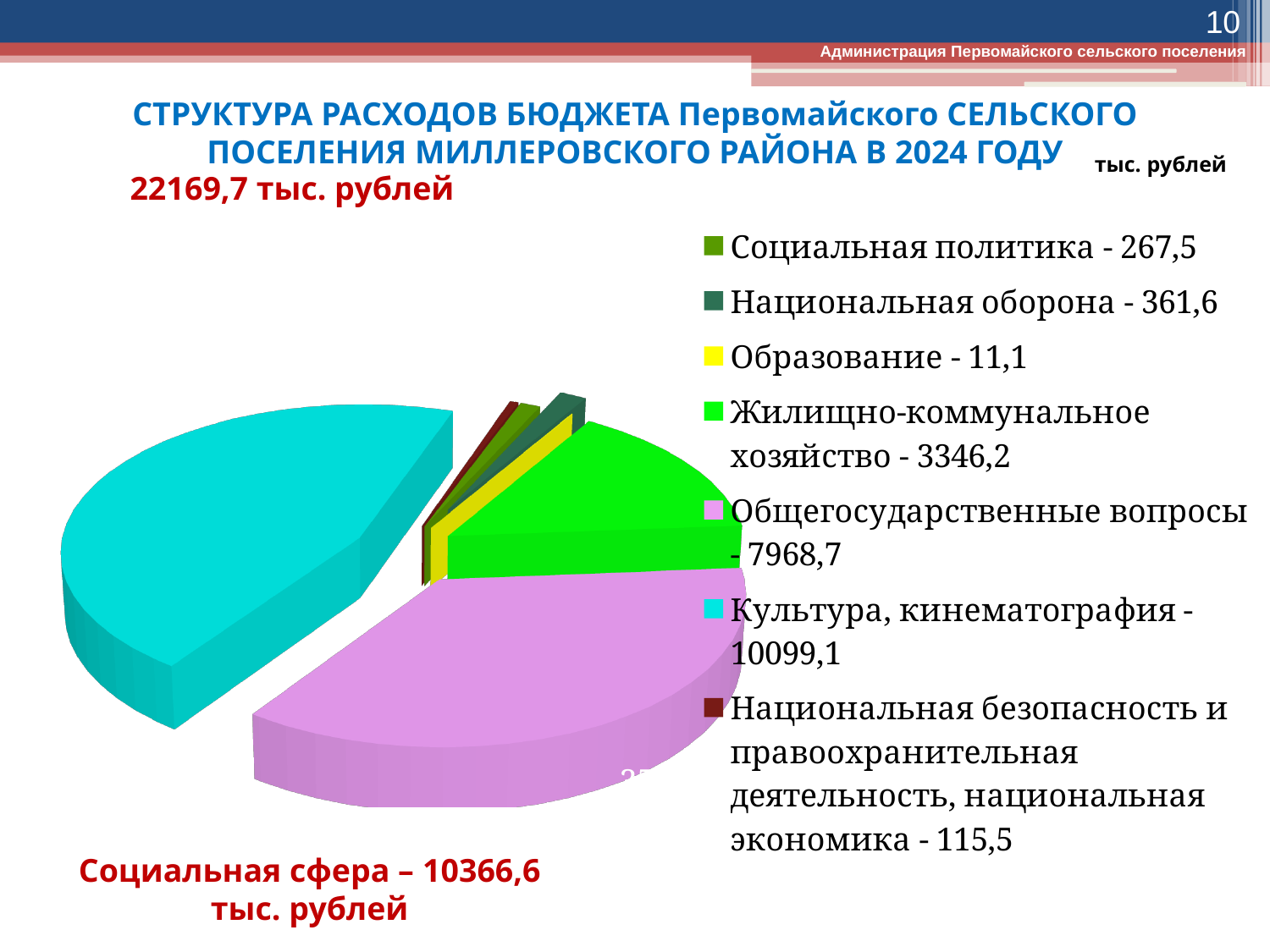
What colour is the slice for Общегосударственные вопросы? pink (light purple) What is the value for Общегосударственные вопросы? 7968,7 What is the difference between the values for Национальная оборона and Социальная политика? 94,1 What is the value for Жилищно-коммунальное хозяйство? 3346,2 What is the value for Культура, кинематография? 10099,1 What kind of chart is shown on the slide? pie chart Which is larger: Национальная оборона or Социальная политика? Национальная оборона Which category has the largest value? Культура, кинематография Which category has the smallest value? Образование What is the difference between the values for Культура, кинематография and Общегосударственные вопросы? 2130,4 What is the value for Образование? 11,1 How many categories does the pie chart have? 7